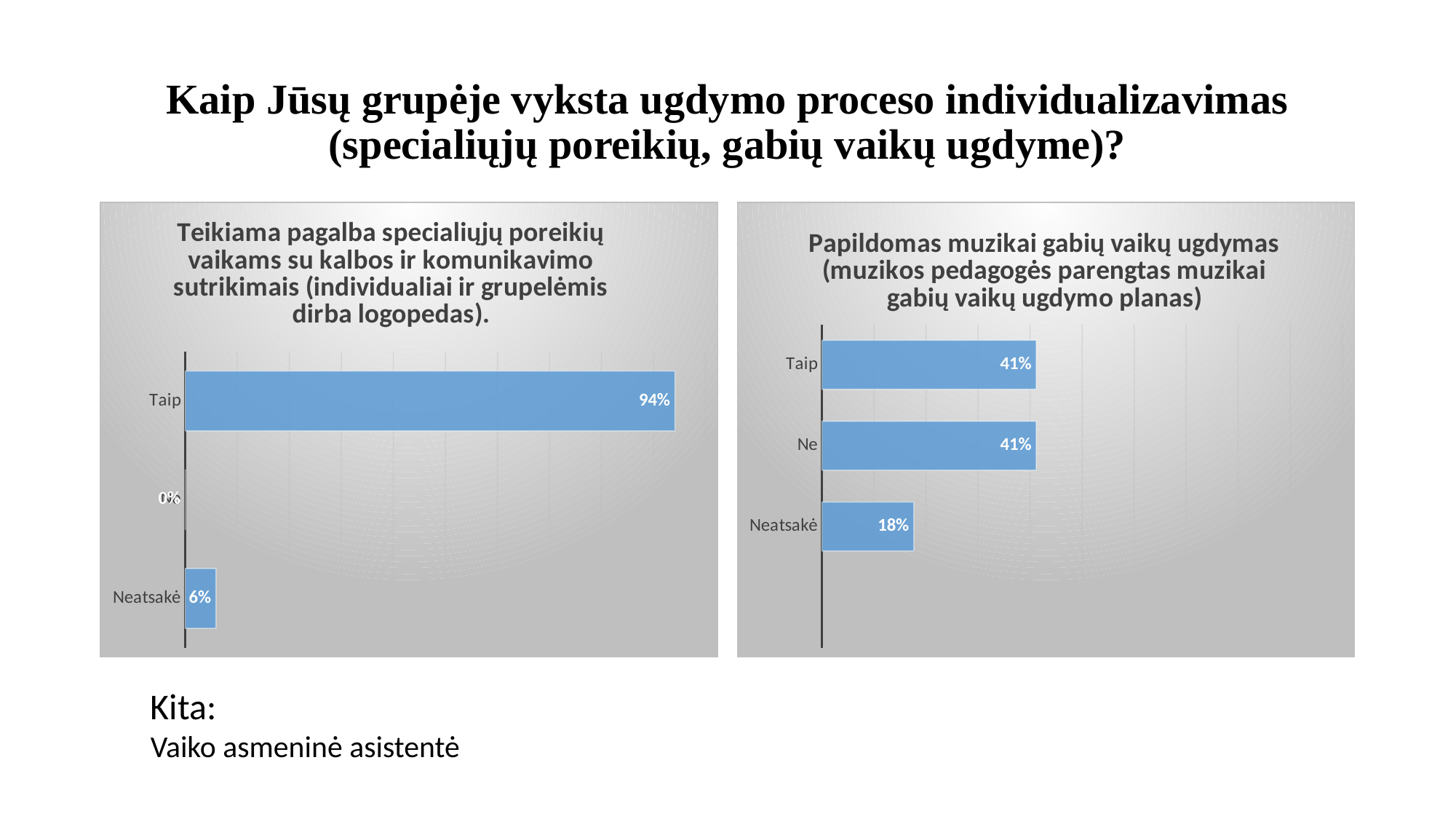
How many categories are shown in the right chart? 3 In the right chart, what is the difference between the values for Taip and Neatsakė? 23% In the left chart, which category has the highest value? Taip In the right chart, which category has the lowest value? Neatsakė In the right chart, which is larger, the value for Taip or the value for Neatsakė? Taip In the left chart, what is the value for Neatsakė? 6% In the right chart, what is the value for Neatsakė? 18% What kind of chart is the right chart? Bar chart In the left chart, what is the value for Taip? 94% What is the title of the left chart? Teikiama pagalba specialiųjų poreikių vaikams su kalbos ir komunikavimo sutrikimais (individualiai ir grupelėmis dirba logopedas). In the left chart, what is the difference between the values for Taip and Neatsakė? 88% In the right chart, what is the value for Ne? 41%